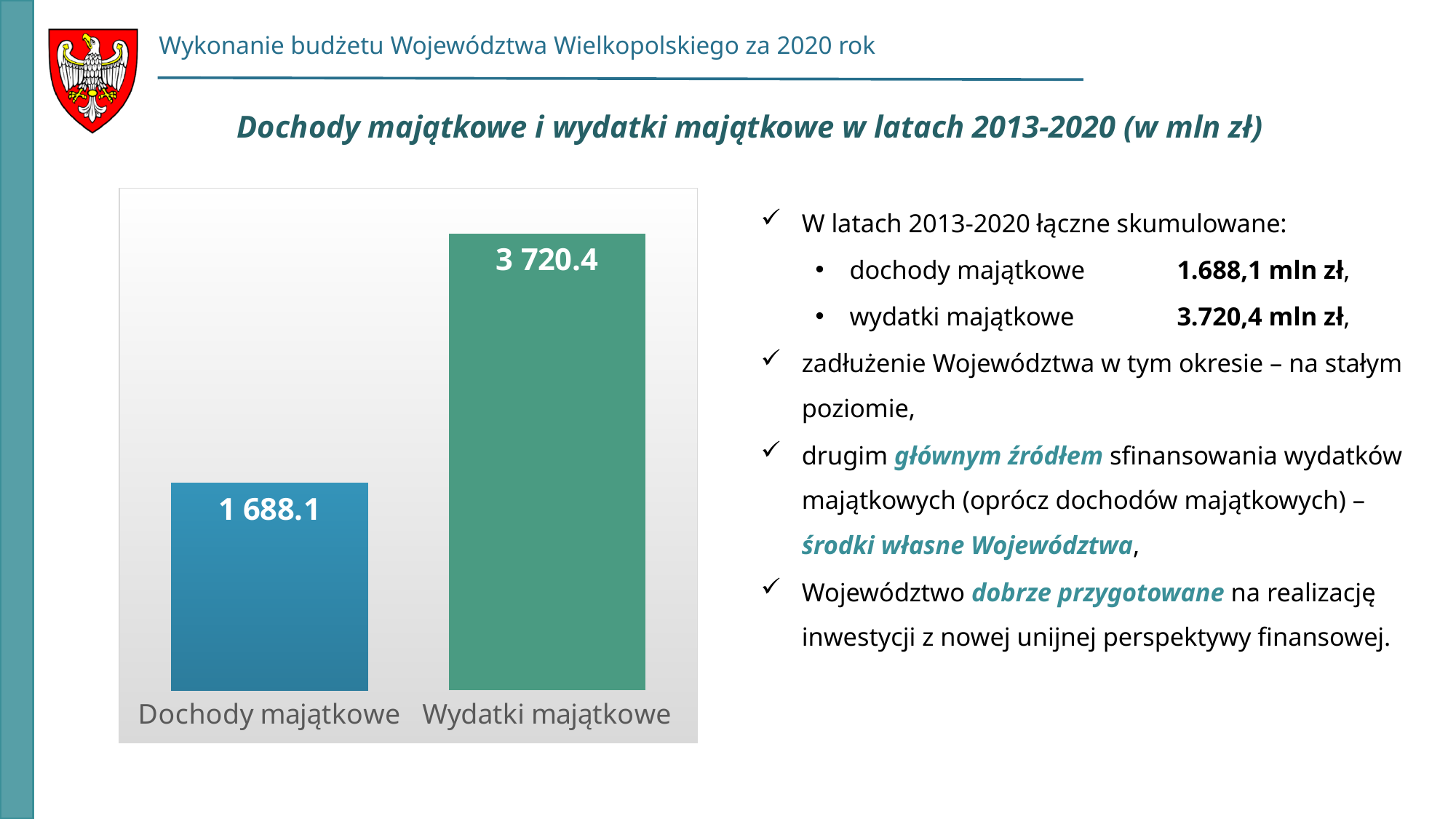
What is the value shown for Wydatki majątkowe? 3 720.4 How many categories are shown in the chart? 2 Which category has the highest value in the chart? Wydatki majątkowe Which is larger, the value for Dochody majątkowe or the value for Wydatki majątkowe? Wydatki majątkowe What is the sum of the two values shown in the chart? 5 408.5 What is the title of the chart? Dochody majątkowe i wydatki majątkowe w latach 2013-2020 (w mln zł) What kind of chart is shown on the slide? Bar chart What is the value shown for Dochody majątkowe? 1 688.1 What colour is the bar for Wydatki majątkowe? Green Which category has the lowest value in the chart? Dochody majątkowe What is the difference between the values for Wydatki majątkowe and Dochody majątkowe? 2 032.3